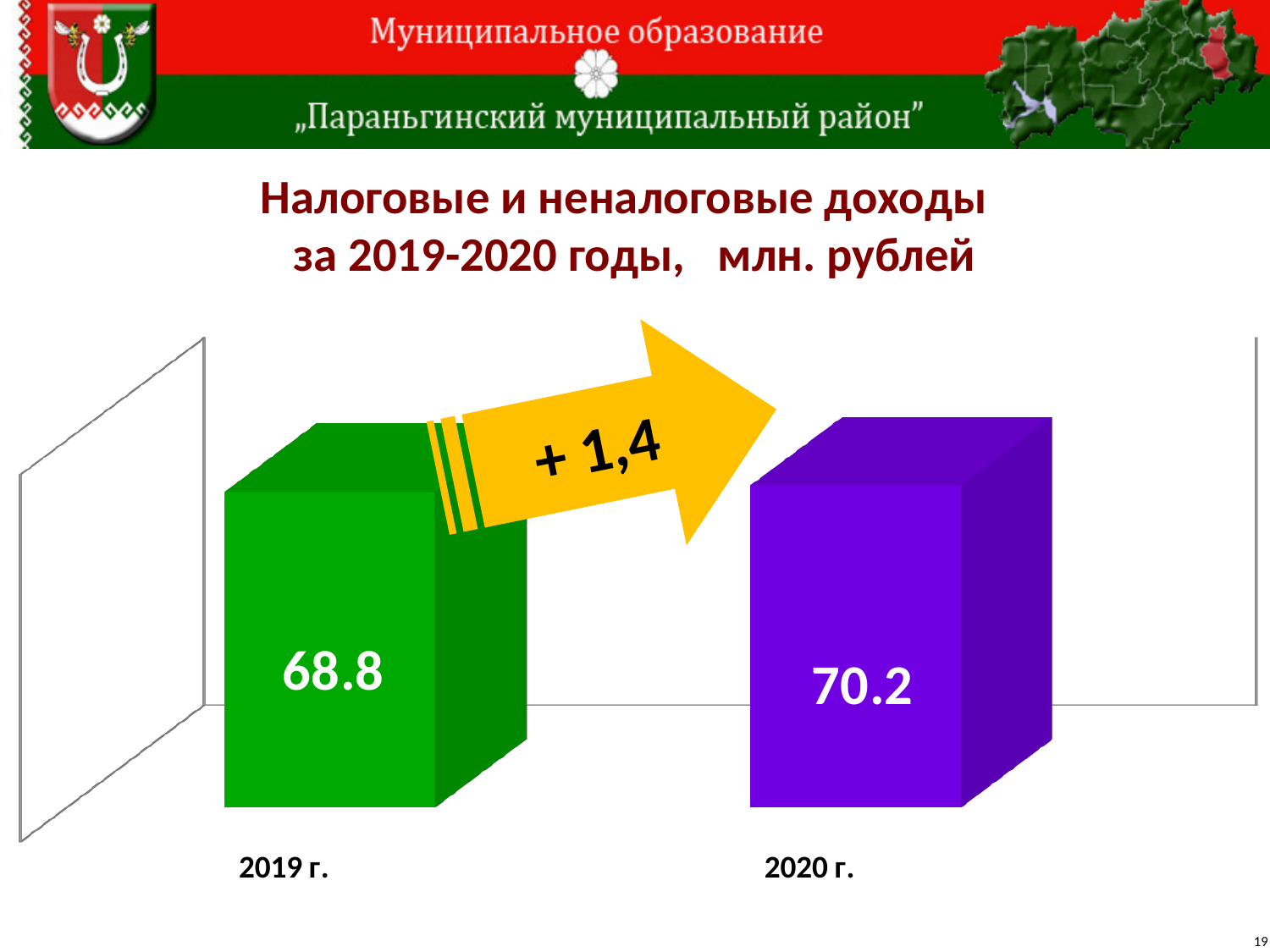
Is the value for 2020 г. larger or smaller than the value for 2019 г.? larger What is the value for 2020 г.? 70.2 Do the values rise or fall from 2019 г. to 2020 г.? rise Which year has the higher value? 2020 г. What kind of chart is shown on the slide? bar chart What change is written on the arrow between the two bars? + 1,4 What colour is the bar for 2019 г.? green What is the difference between the 2020 г. and 2019 г. values? 1.4 How many categories are shown in the chart? 2 Which year has the lower value? 2019 г. What is the value for 2019 г.? 68.8